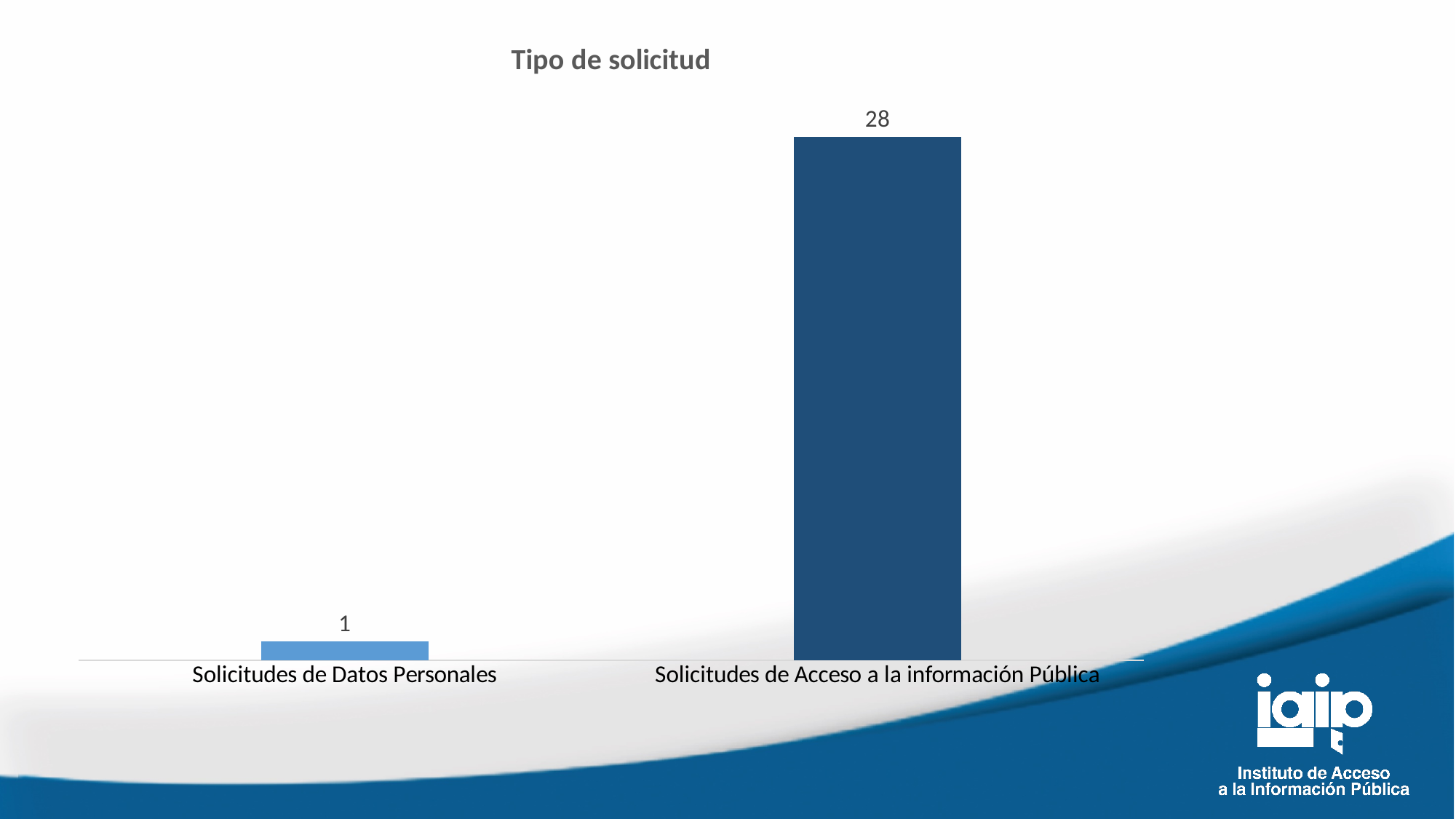
What is the title of the chart? Tipo de solicitud Which category has the highest value? Solicitudes de Acceso a la información Pública What is the value for Solicitudes de Datos Personales? 1 Which category has the lowest value? Solicitudes de Datos Personales Which is larger: the value for Solicitudes de Datos Personales or the value for Solicitudes de Acceso a la información Pública? Solicitudes de Acceso a la información Pública What is the value for Solicitudes de Acceso a la información Pública? 28 What kind of chart is shown on the slide? Bar chart Do the values rise or fall from left to right along the x axis? Rise What is the total of the two values shown in the chart? 29 What is the difference between the values for Solicitudes de Acceso a la información Pública and Solicitudes de Datos Personales? 27 How many categories are shown in the chart? 2